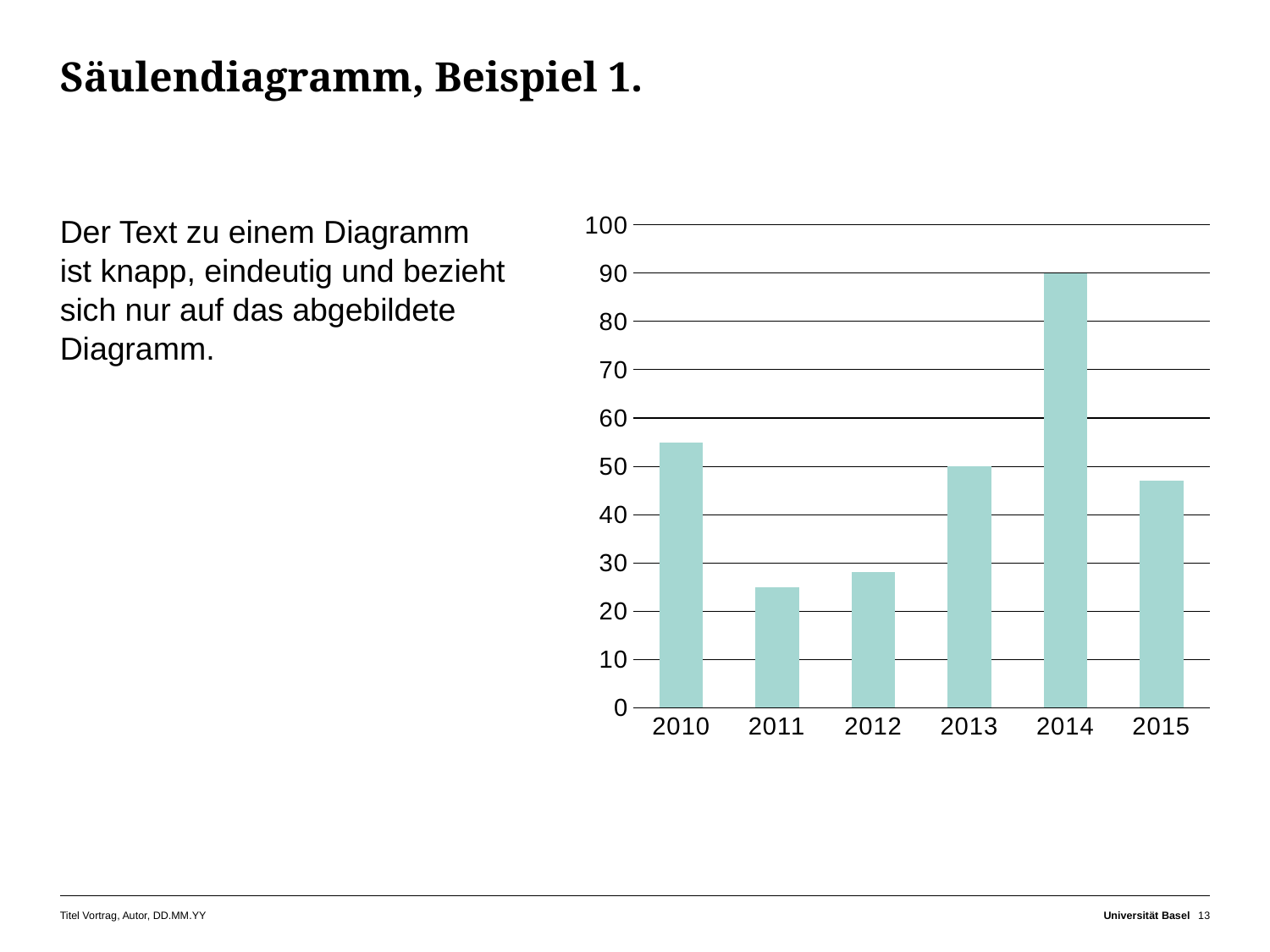
Do the values rise or fall from 2011 to 2014? rise Is the value for 2010 greater or less than 50? greater What kind of chart is shown on the slide? bar chart What is the value for 2013 in the chart? 50 Which year has the lowest bar in the chart? 2011 Which year has the highest bar in the chart? 2014 What is the difference between the values for 2014 and 2013? 40 Is the value for 2015 greater or less than 40? greater What is the value for 2014 in the chart? 90 Which year has the larger value, 2010 or 2013? 2010 Is the value for 2011 greater or less than 30? less How many years are shown on the x axis of the chart? 6